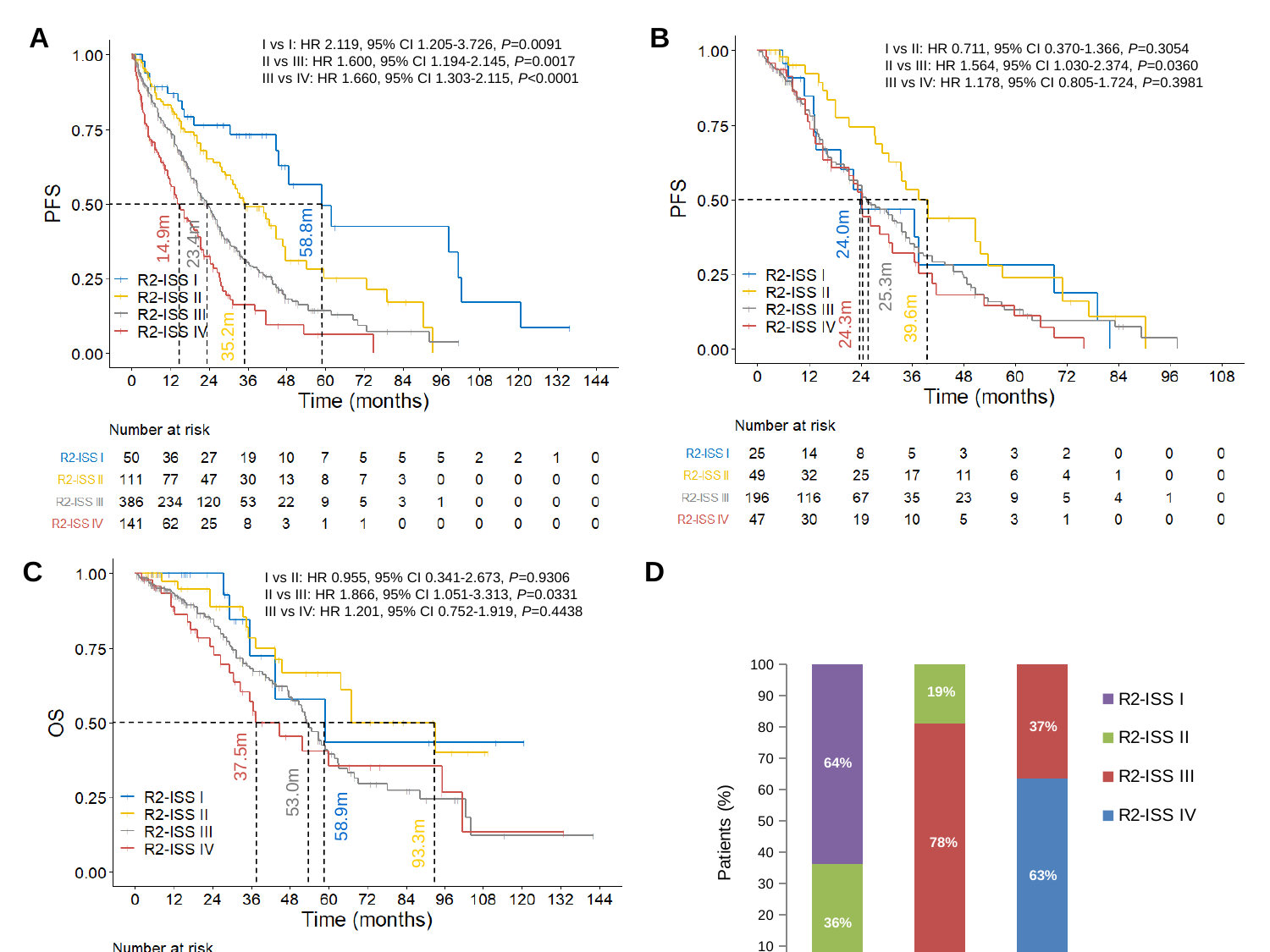
In panel D, how many series does the legend list? 4 In panel C, what is the median OS shown for R2-ISS IV? 37.5m In panel A, what is the median PFS shown for R2-ISS I? 58.8m In panel D, what percentage of the leftmost bar is R2-ISS I? 64% In panel C, which is larger, the median OS for R2-ISS II or for R2-ISS III? R2-ISS II In panel D, what percentage of the rightmost bar is R2-ISS IV? 63% In panel A, which R2-ISS group has the shortest median PFS? R2-ISS IV In panel C, what is the difference between the median OS of R2-ISS II and R2-ISS I? 34.4m In panel A, how many R2-ISS III patients are at risk at time 0? 386 In panel B, which R2-ISS group has the longest median PFS? R2-ISS II What kind of chart is panel D? Stacked bar chart In panel B, what is the median PFS shown for R2-ISS II? 39.6m